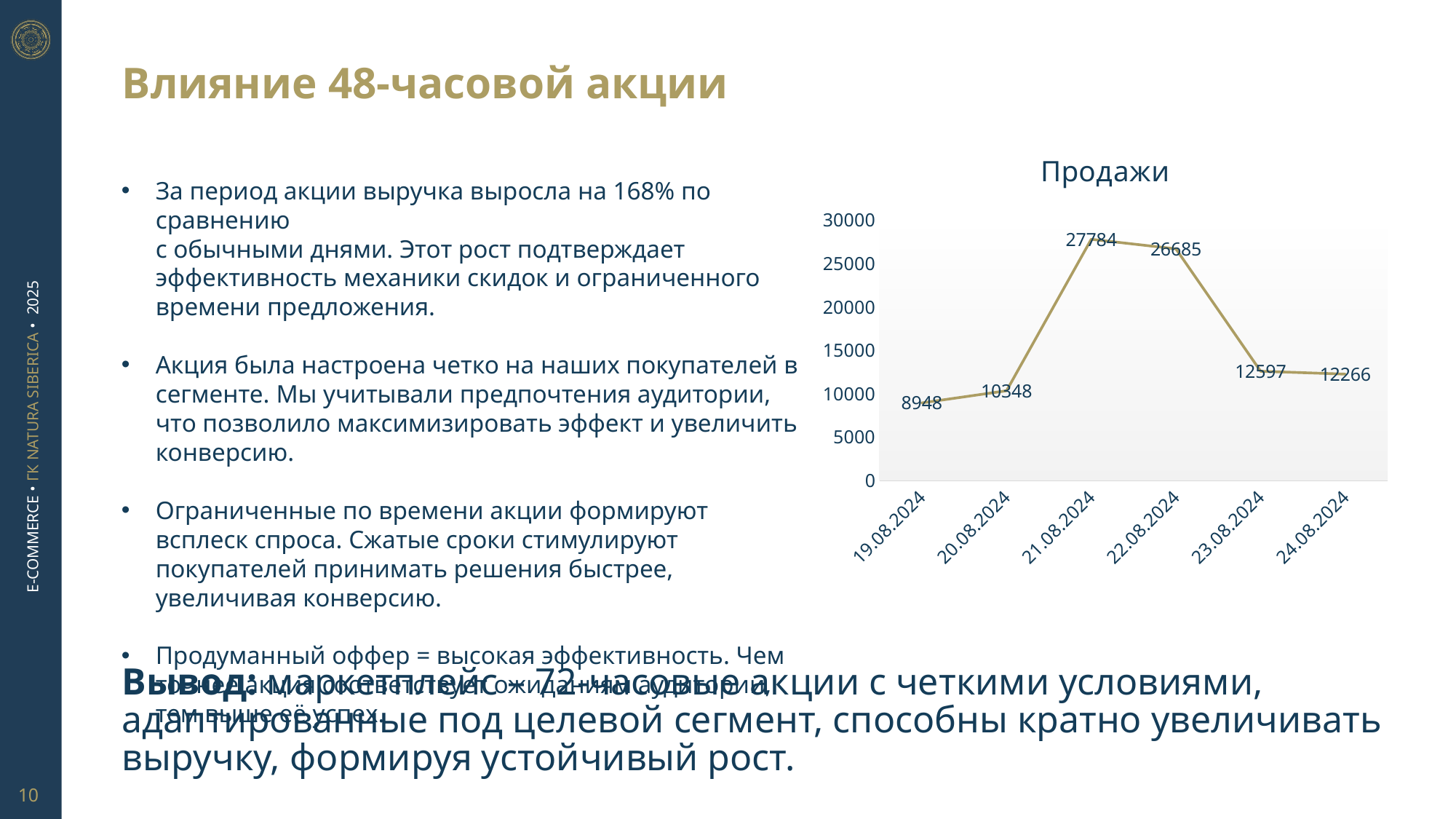
Do the values rise or fall from 22.08.2024 to 24.08.2024? fall What is the value for 19.08.2024? 8948 What type of chart is shown on the slide? Line chart What is the value for 23.08.2024? 12597 What is the title of the chart? Продажи What is the difference between the values for 21.08.2024 and 22.08.2024? 1099 How many dates are plotted on the x axis? 6 Which date has the highest value? 21.08.2024 Which date has the lowest value? 19.08.2024 Is the value for 22.08.2024 greater or less than 20000? greater Which is larger, the value for 20.08.2024 or the value for 24.08.2024? 24.08.2024 What is the value for 21.08.2024? 27784